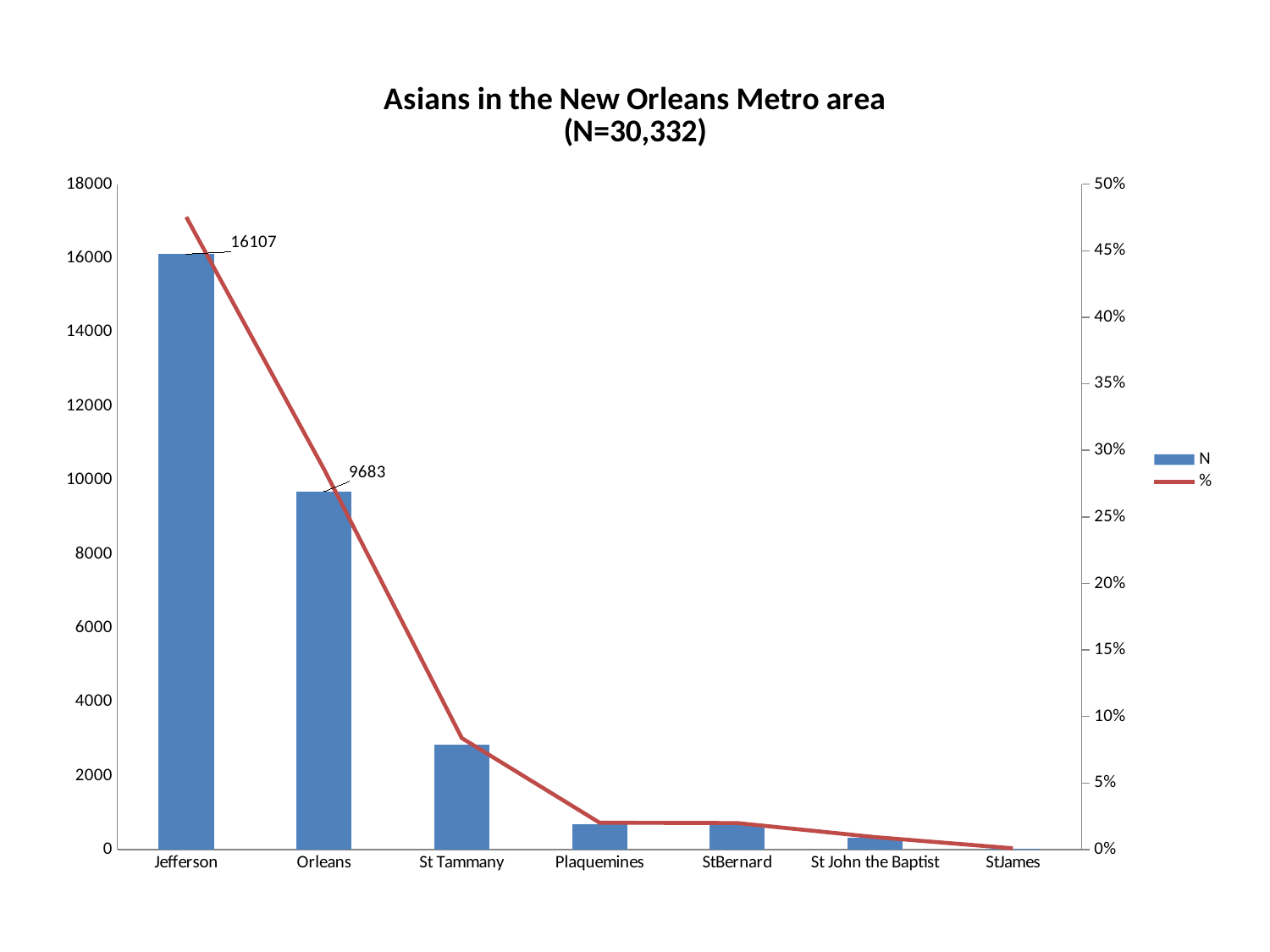
Which parish has the lowest N value? StJames What is the value of N for Jefferson? 16107 Do the N values rise or fall from left to right along the x axis? fall Is the N value for St Tammany greater or less than 2000? greater What is the value of N for Orleans? 9683 Is the % value for Jefferson greater or less than 45%? greater How many series does the legend list? 2 Which parish has the highest N value? Jefferson Which has a larger N value, Orleans or St Tammany? Orleans How many parishes are shown on the x axis? 7 What is the difference between the N values for Jefferson and Orleans? 6424 Is the N value for St Tammany greater or less than 4000? less